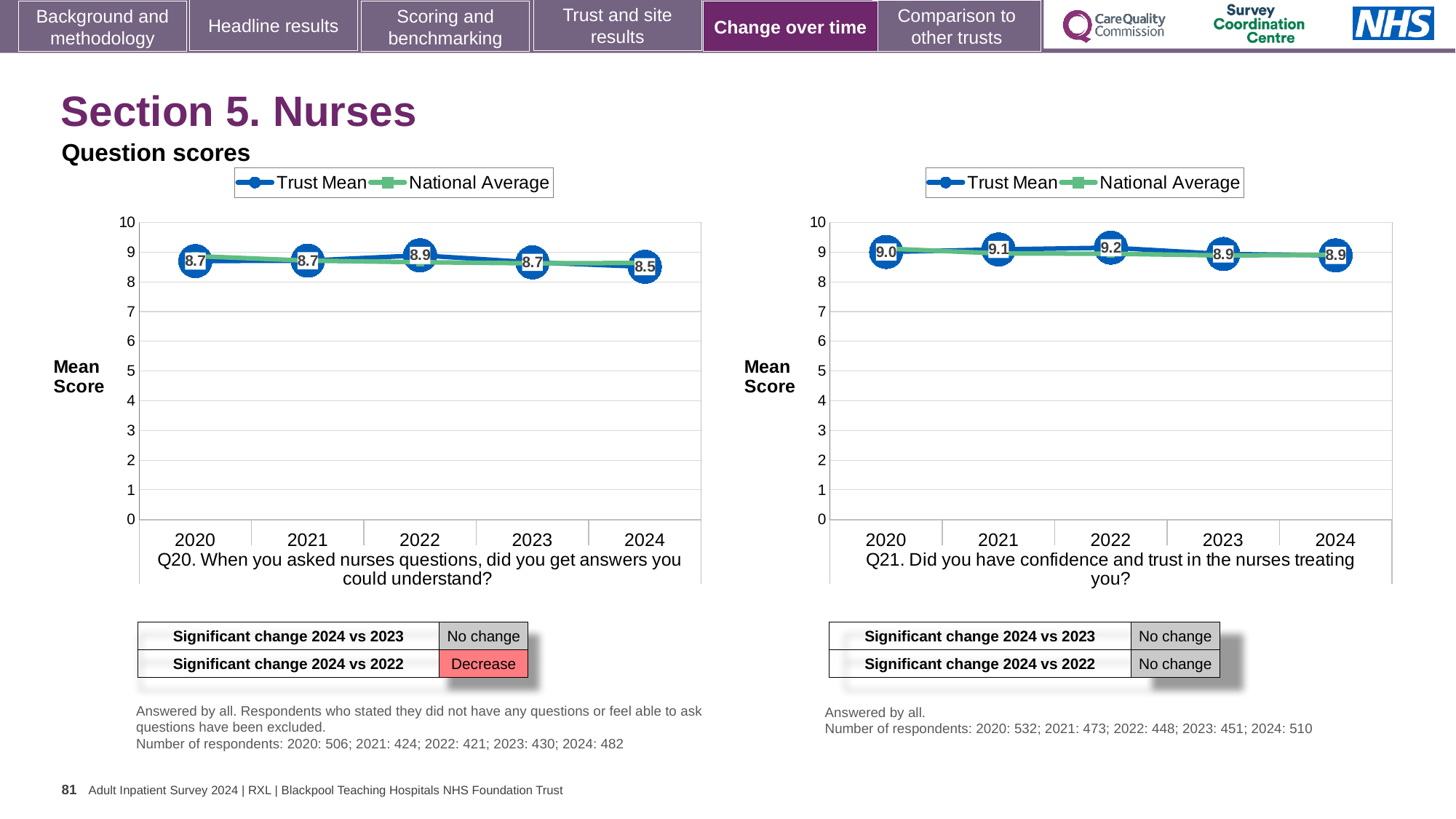
In the Q20 chart (left), which year has the lowest Trust Mean score? 2024 In the Q20 chart (left), what is the Trust Mean score for 2022? 8.9 In the Q20 chart (left), what is the Trust Mean score for 2024? 8.5 In the Q20 chart (left), which year has the highest Trust Mean score? 2022 How many years are plotted on the x axis of the Q20 chart (left)? 5 Which is larger: the 2024 Trust Mean score in the Q20 chart (left) or the 2024 Trust Mean score in the Q21 chart (right)? Q21 chart (right) In the Q21 chart (right), what is the Trust Mean score for 2020? 9.0 In the Q21 chart (right), what is the Trust Mean score for 2022? 9.2 How many series does the legend of the Q21 chart (right) list? 2 In the Q20 chart (left), what is the difference between the Trust Mean scores for 2022 and 2024? 0.4 In the Q21 chart (right), which year has the highest Trust Mean score? 2022 In the Q21 chart (right), what is the difference between the Trust Mean scores for 2022 and 2024? 0.3